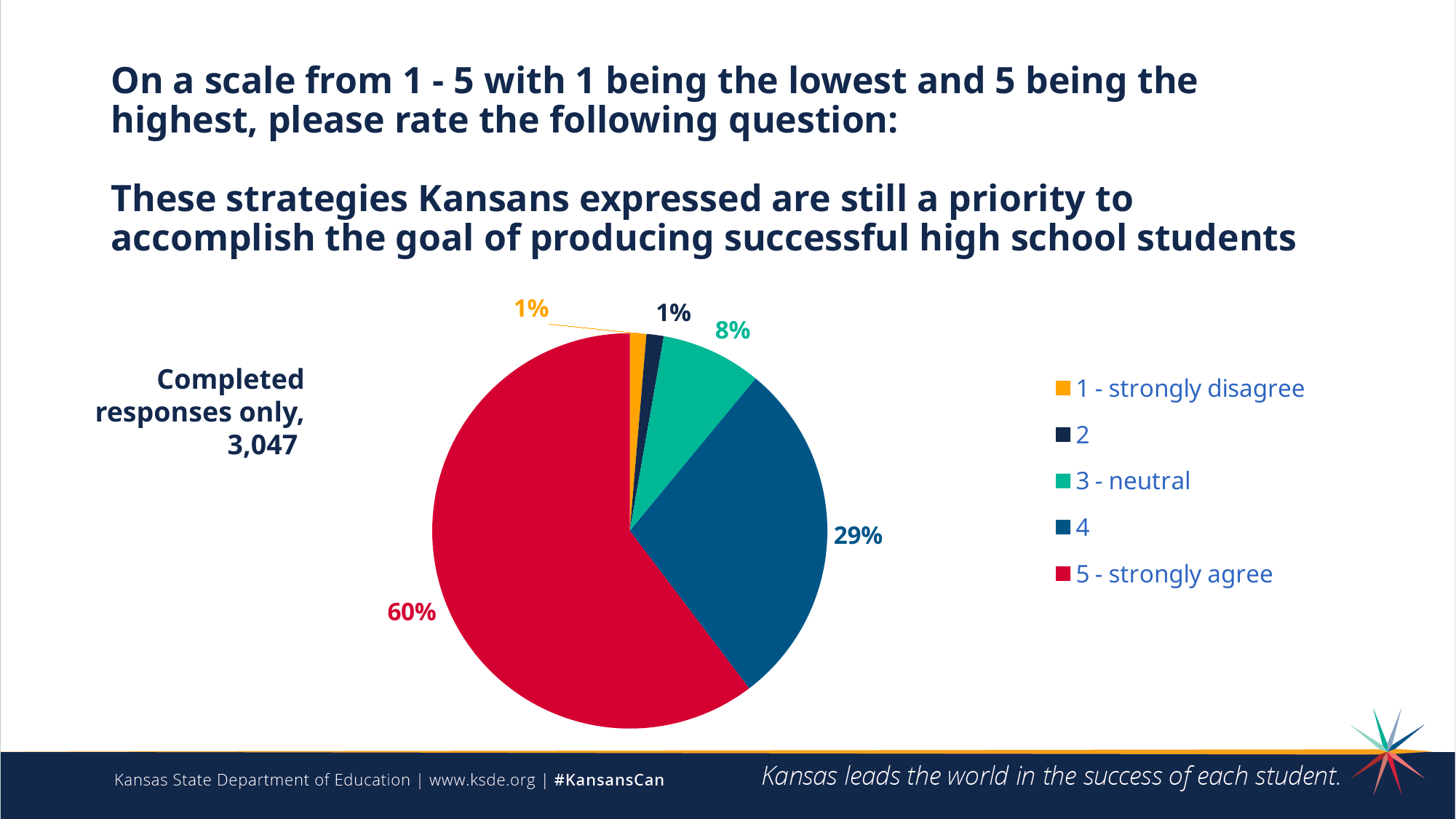
How many categories does the legend list? 5 What kind of chart is shown on the slide? pie chart How many completed responses does the slide say the chart is based on? 3,047 Which is larger, the share for '4' or the share for '3 - neutral'? 4 What colour is the slice for '5 - strongly agree'? red What share of responses is '5 - strongly agree'? 60% What is the combined share of '4' and '5 - strongly agree'? 89% What share of responses is '3 - neutral'? 8% What share of responses is '4'? 29% What is the difference in percentage points between '5 - strongly agree' and '4'? 31 Which response category has the largest slice of the pie? 5 - strongly agree